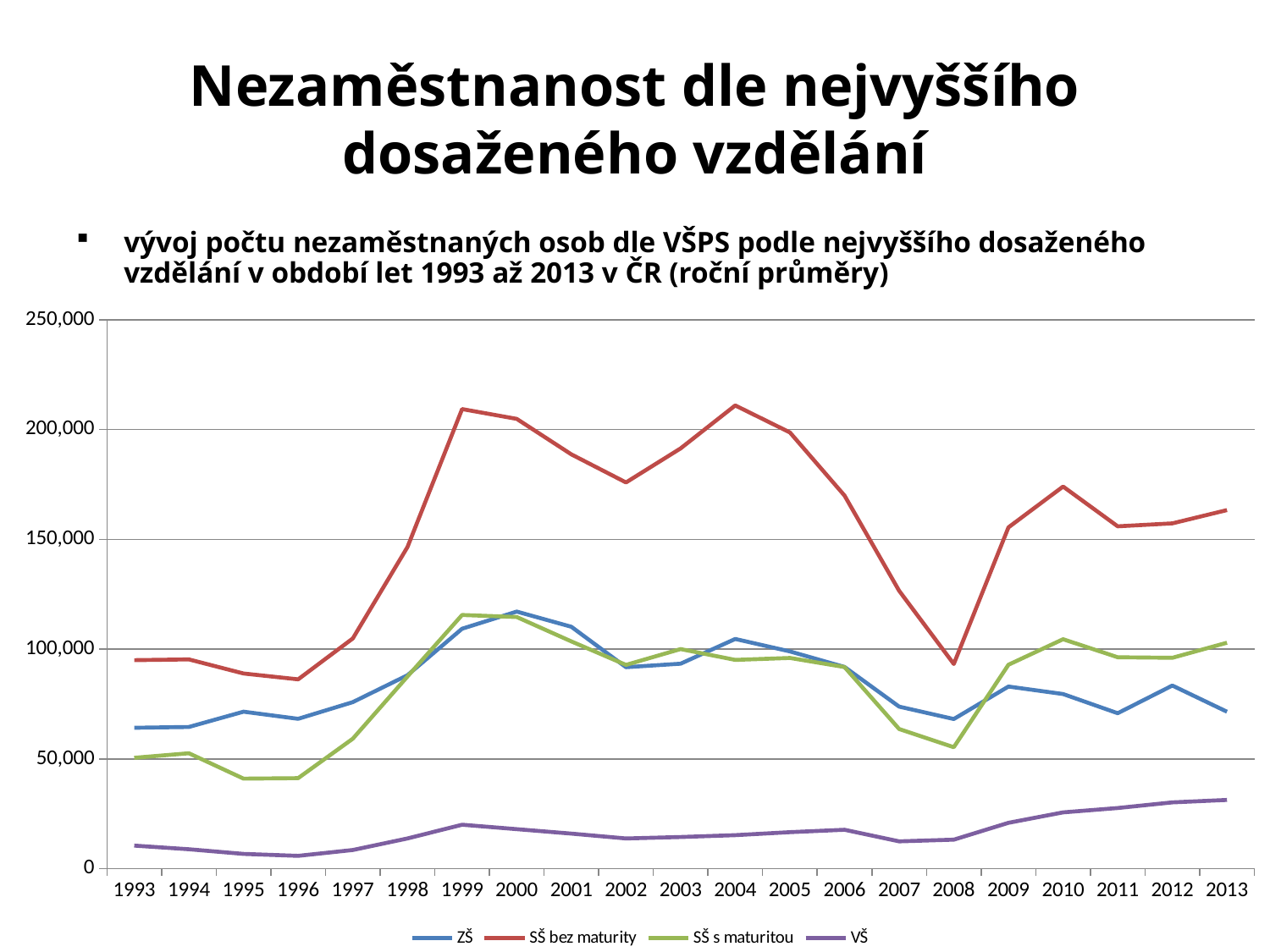
Which series has the highest values across the whole period? SŠ bez maturity What kind of chart is shown on the slide? line chart Which series has the lowest values across the whole period? VŠ Is the value for SŠ s maturitou in 1995 greater or less than 50,000? less Is the value for SŠ bez maturity in 2008 greater or less than 100,000? less Is the value for ZŠ in 2000 greater or less than 100,000? greater How many years are plotted along the x axis? 21 Does the VŠ series rise or fall from 2008 to 2013? rise In 1995, which is larger: the value for ZŠ or the value for SŠ s maturitou? ZŠ How many series does the legend list? 4 What colour is the line for SŠ bez maturity? red